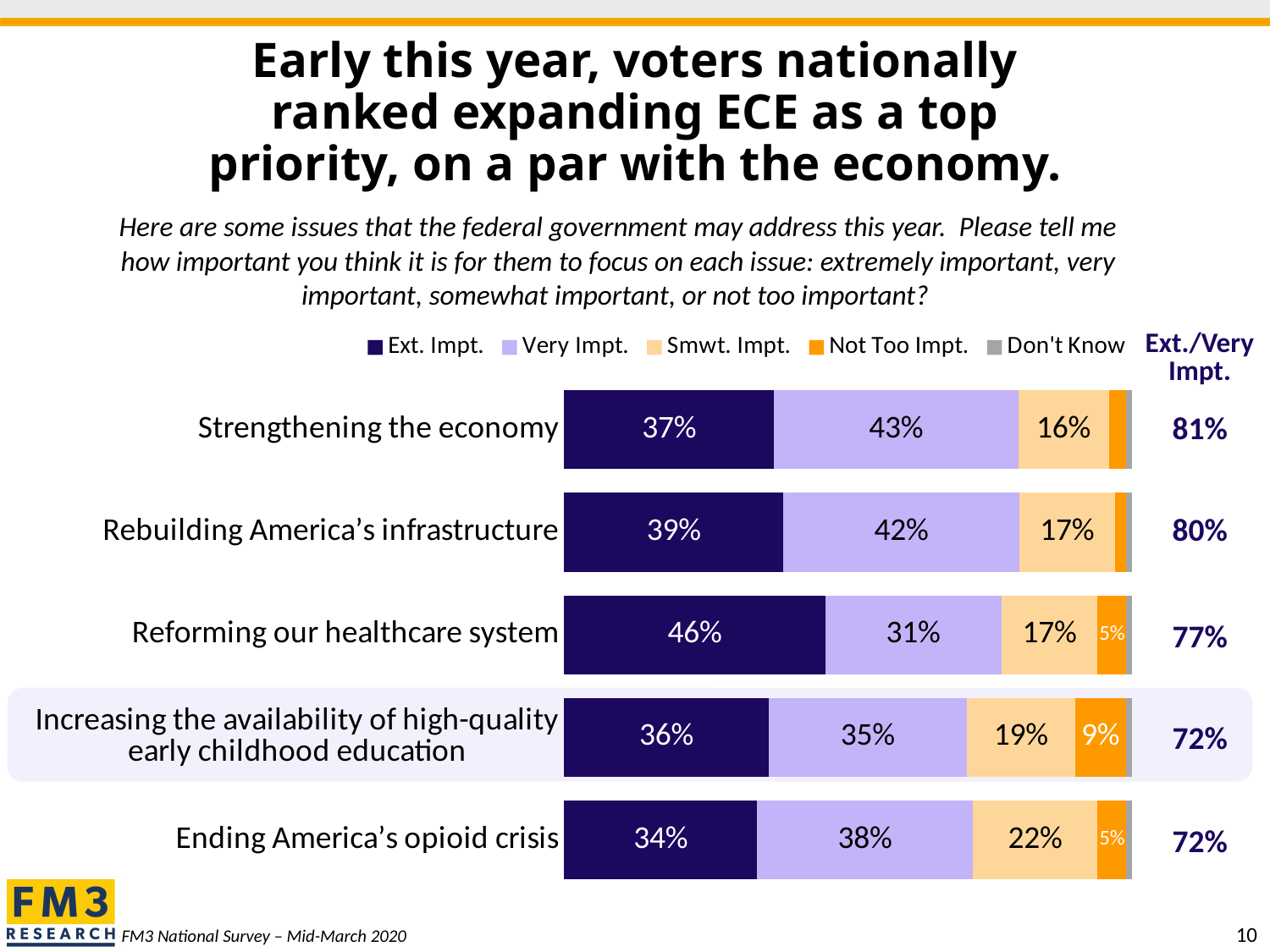
What is the combined 'Ext./Very Impt.' value shown for 'Increasing the availability of high-quality early childhood education'? 72% Which issue has the lowest 'Ext. Impt.' value? Ending America's opioid crisis Which issue has the highest 'Ext. Impt.' value? Reforming our healthcare system What is the 'Smwt. Impt.' value for 'Ending America's opioid crisis'? 22% What is the 'Not Too Impt.' value for 'Increasing the availability of high-quality early childhood education'? 9% What is the difference between the 'Ext. Impt.' values for 'Reforming our healthcare system' and 'Strengthening the economy'? 9 percentage points How many issues (categories) are plotted in the chart? 5 What is the 'Very Impt.' value for 'Rebuilding America's infrastructure'? 42% Which is larger: the 'Very Impt.' value for 'Strengthening the economy' or for 'Reforming our healthcare system'? Strengthening the economy What percentage of voters rated 'Strengthening the economy' as extremely important? 37% What kind of chart is shown on the slide? Stacked bar chart How many series does the legend list? 5